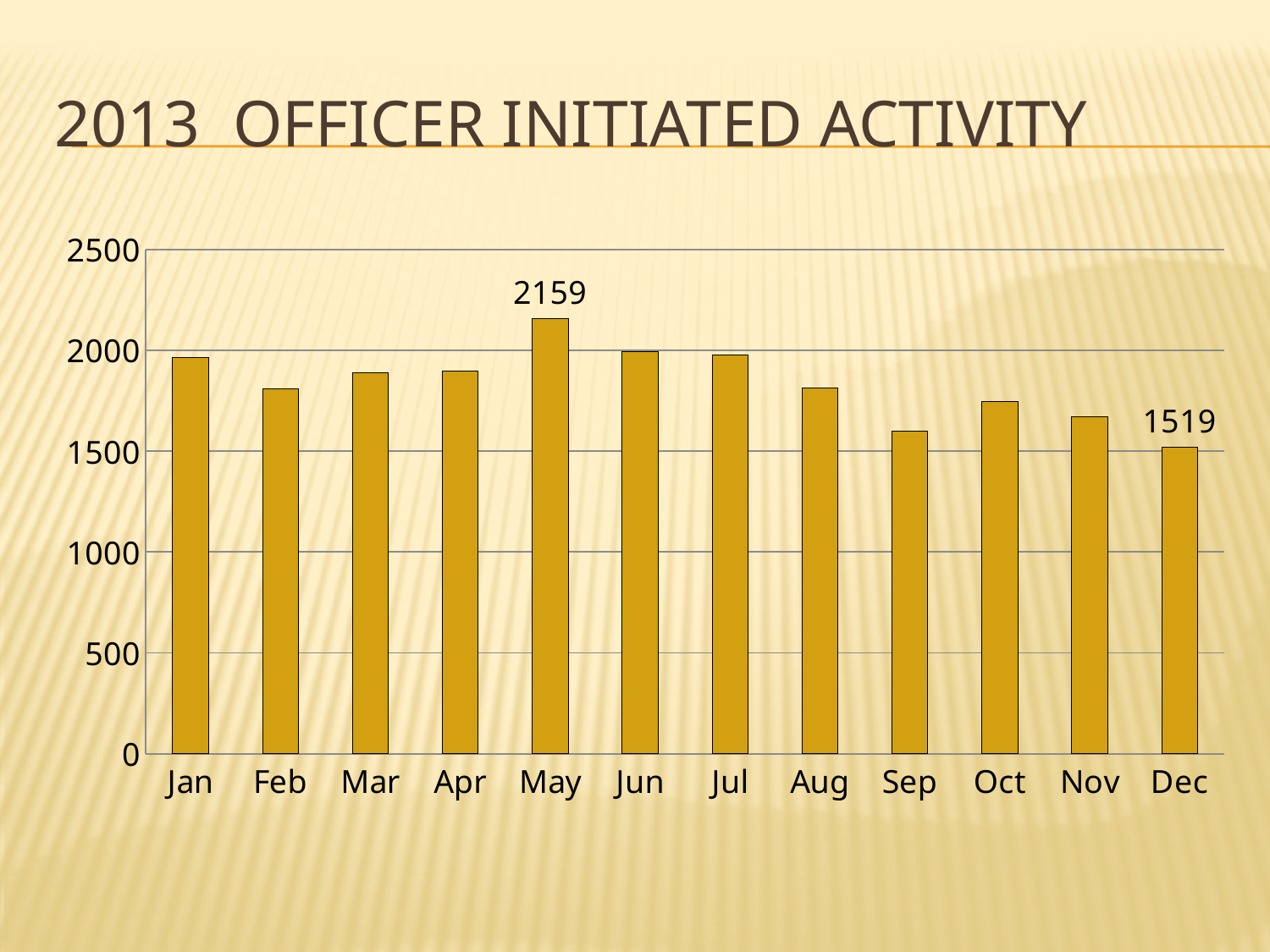
Which is larger, the value for Sep or the value for Oct? Oct What is the title of the slide? 2013 OFFICER INITIATED ACTIVITY What is the value for Dec? 1519 What is the difference between the values for May and Dec? 640 Which is larger, the value for Jan or the value for Feb? Jan What kind of chart is shown on the slide? bar chart How many months are shown on the x axis? 12 Which month has the lowest value? Dec Is the value for Aug greater or less than 1500? greater What is the value for May? 2159 Is the value for Sep greater or less than 2000? less Which month has the highest value? May